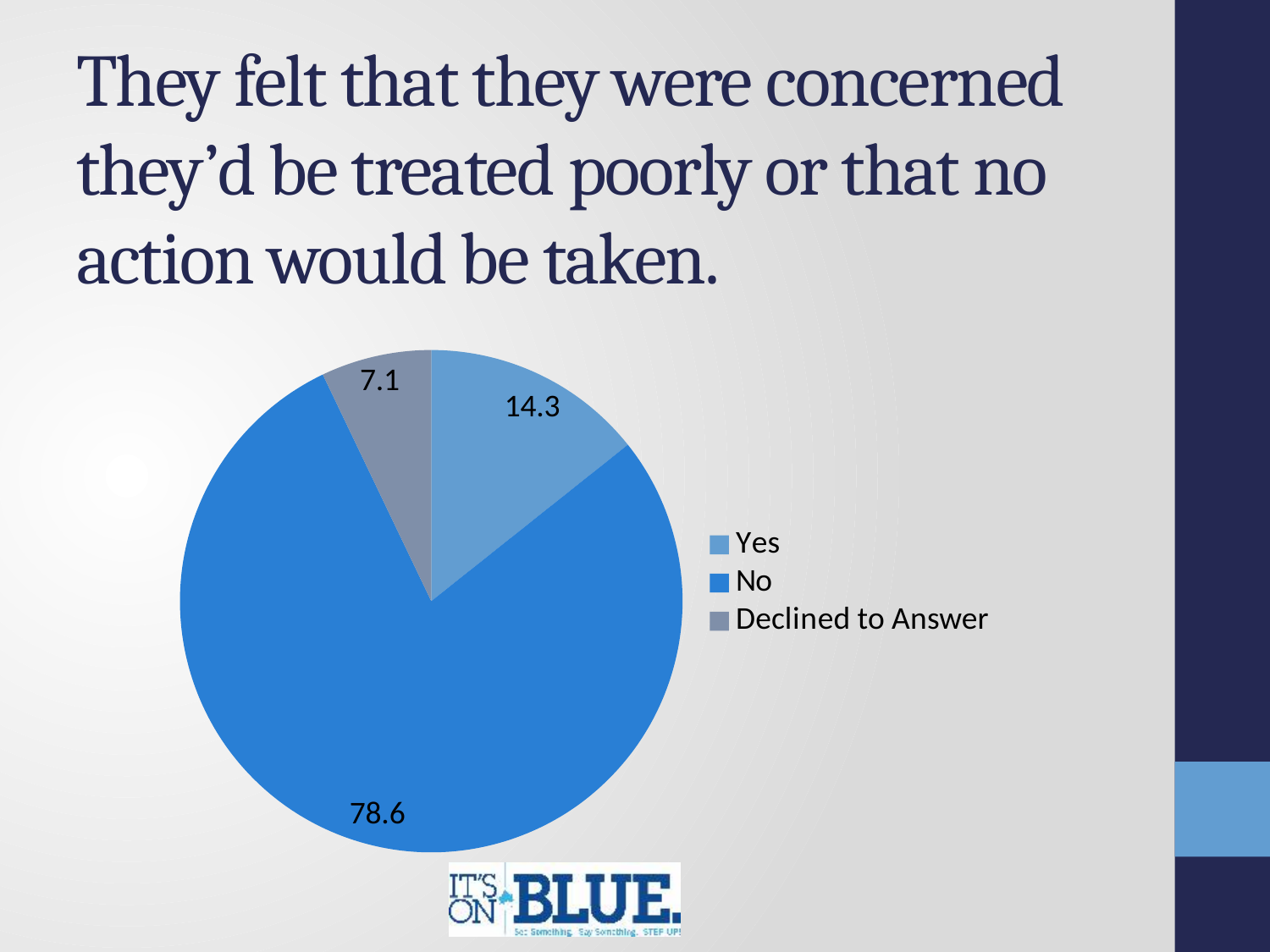
How many slices does the pie chart have? 3 What is the difference between the values for "No" and "Yes"? 64.3 What kind of chart is shown on the slide? pie chart What is the difference between the values for "Yes" and "Declined to Answer"? 7.2 Which category has the largest slice of the pie? No What is the value for the "No" slice? 78.6 What is the value for the "Declined to Answer" slice? 7.1 Which category has the smallest slice of the pie? Declined to Answer What is the legend label for the darkest blue slice? No Which is larger, the value for "Yes" or the value for "Declined to Answer"? Yes How many entries does the legend list? 3 What is the value for the "Yes" slice? 14.3